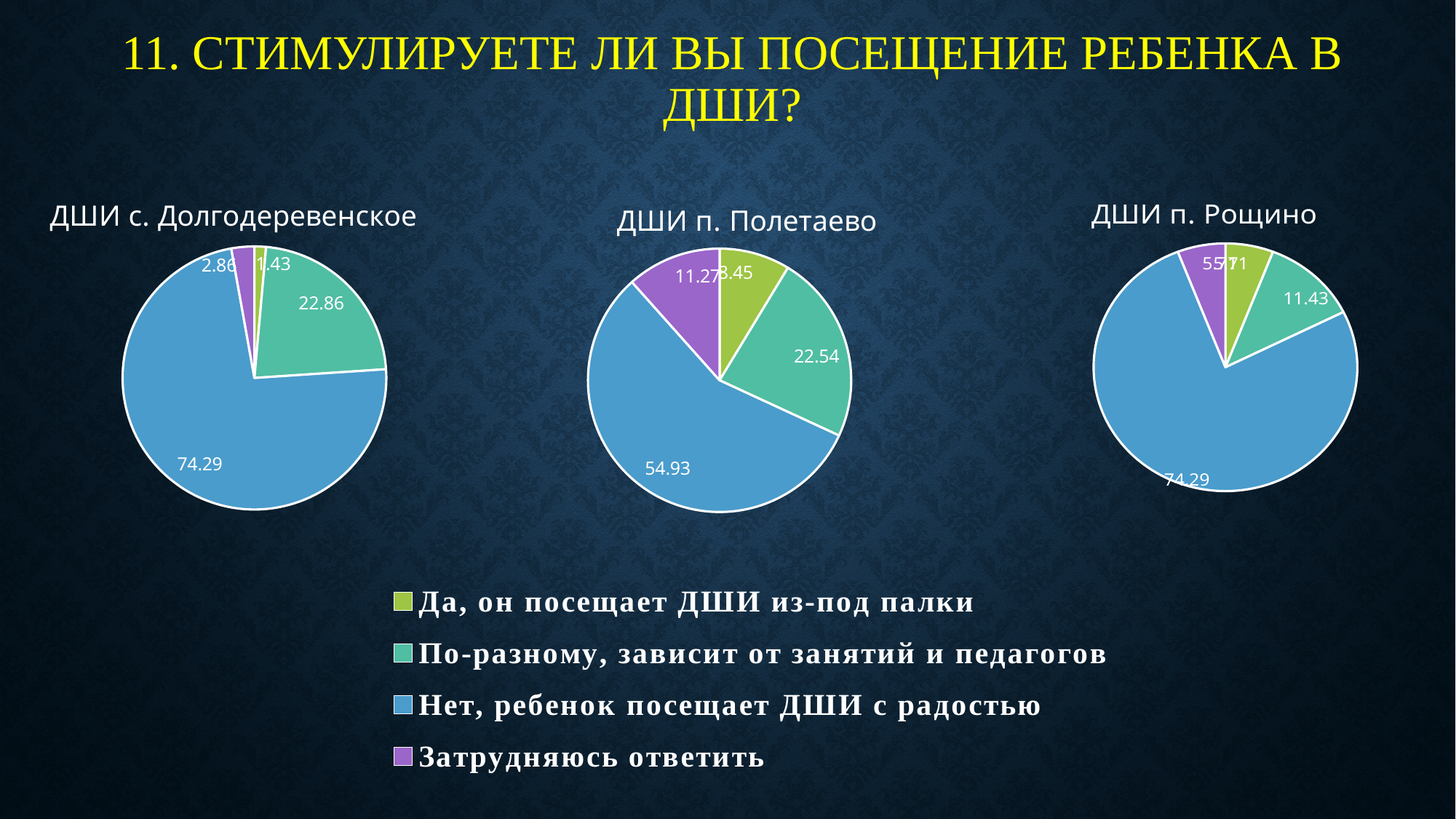
In the pie chart titled "ДШИ п. Полетаево", what is the difference between the values for "Нет, ребенок посещает ДШИ с радостью" and "По-разному, зависит от занятий и педагогов"? 32.39 How many entries does the shared legend list? 4 In the pie chart titled "ДШИ п. Рощино", what is the value for "По-разному, зависит от занятий и педагогов"? 11.43 In the pie chart titled "ДШИ с. Долгодеревенское", which category has the smallest slice? Да, он посещает ДШИ из-под палки In the pie chart titled "ДШИ с. Долгодеревенское", what is the value for "Нет, ребенок посещает ДШИ с радостью"? 74.29 In the pie chart titled "ДШИ с. Долгодеревенское", what is the value for "По-разному, зависит от занятий и педагогов"? 22.86 In the pie chart titled "ДШИ с. Долгодеревенское", what is the value for "Затрудняюсь ответить"? 2.86 In the pie chart titled "ДШИ п. Рощино", which category has the largest slice? Нет, ребенок посещает ДШИ с радостью In the pie chart titled "ДШИ п. Полетаево", what is the value for "Нет, ребенок посещает ДШИ с радостью"? 54.93 In the pie chart titled "ДШИ п. Полетаево", what is the value for "По-разному, зависит от занятий и педагогов"? 22.54 Which is larger: the value for "Затрудняюсь ответить" in the "ДШИ п. Полетаево" chart or in the "ДШИ с. Долгодеревенское" chart? ДШИ п. Полетаево In the pie chart titled "ДШИ п. Полетаево", what is the value for "Затрудняюсь ответить"? 11.27